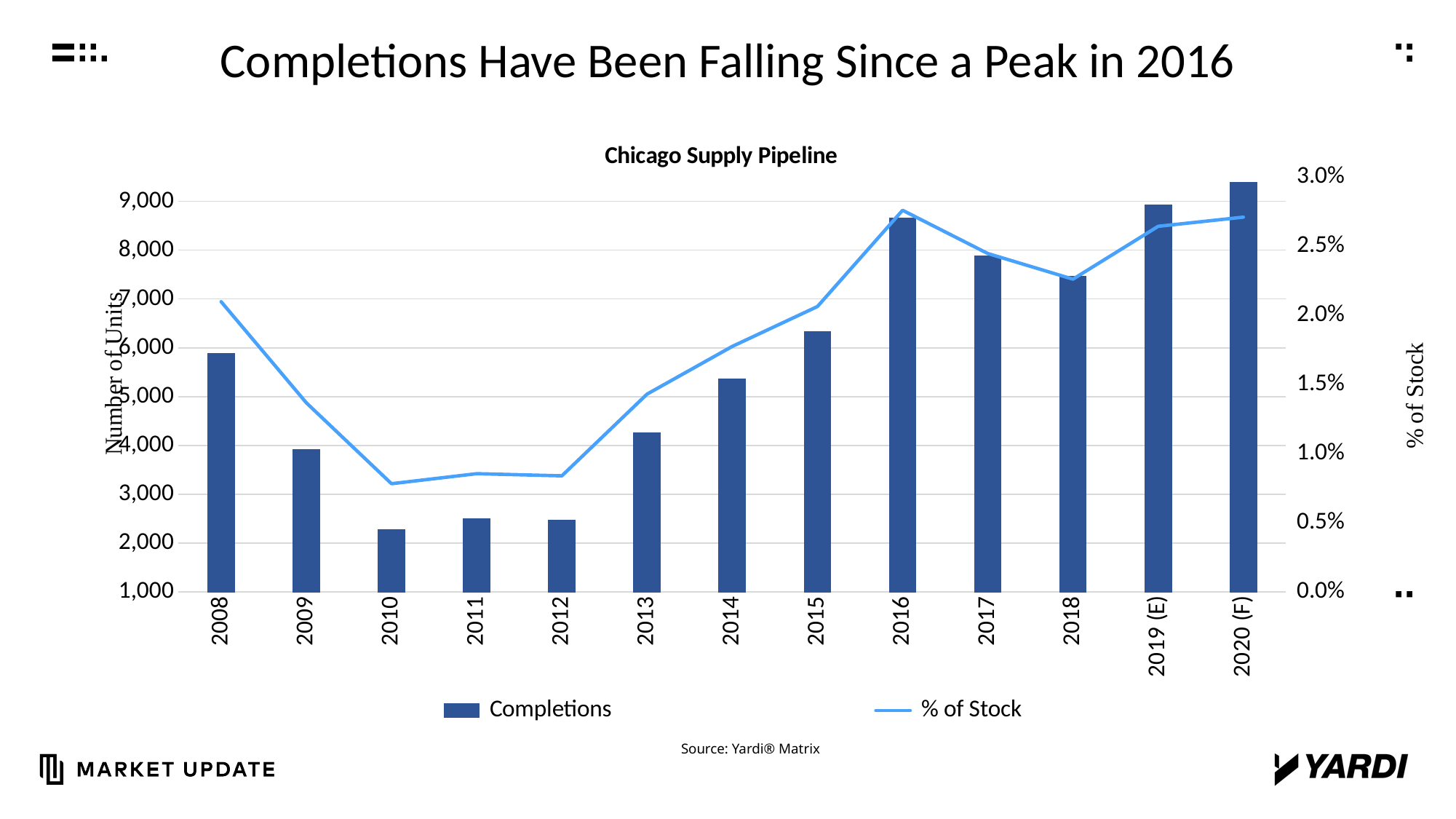
How many series does the chart's legend list? 2 What is the title of the chart on the slide? Chicago Supply Pipeline Is the % of Stock value for 2010 greater or less than 1.0%? less Is the Completions value for 2010 greater or less than 3,000? less Which year has the highest Completions bar? 2020 (F) Which year has more Completions, 2016 or 2017? 2016 Do Completions rise or fall from 2010 to 2016? rise Is the % of Stock value for 2008 greater or less than 2.0%? greater How many years (categories) are shown on the x axis of the chart? 13 Which year has the lowest Completions bar? 2010 What kind of chart is used to show Completions in the Chicago Supply Pipeline chart? Bar chart